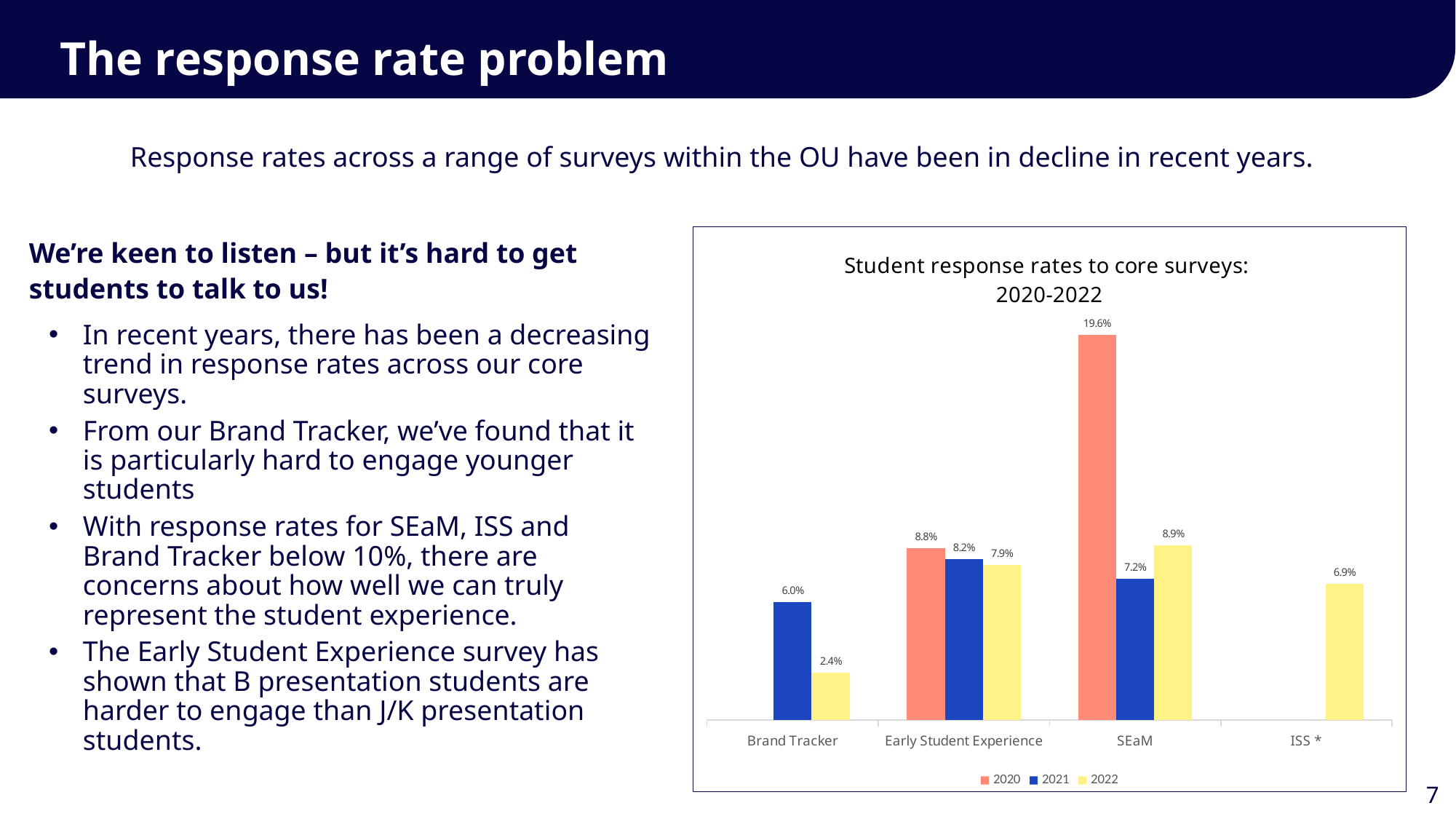
Which is larger: the 2021 response rate for Brand Tracker or the 2021 response rate for SEaM? SEaM What is the 2022 response rate for ISS *? 6.9% Which survey has the lowest 2022 response rate? Brand Tracker What is the title of the chart? Student response rates to core surveys: 2020-2022 What is the 2021 response rate for Early Student Experience? 8.2% How many series does the legend list? 3 What kind of chart is shown? Bar chart What is the 2020 response rate for SEaM? 19.6% What is the difference between the 2020 and 2021 response rates for SEaM? 12.4% Which survey has the highest 2020 response rate? SEaM How many surveys are shown on the x axis? 4 What is the 2022 response rate for Brand Tracker? 2.4%